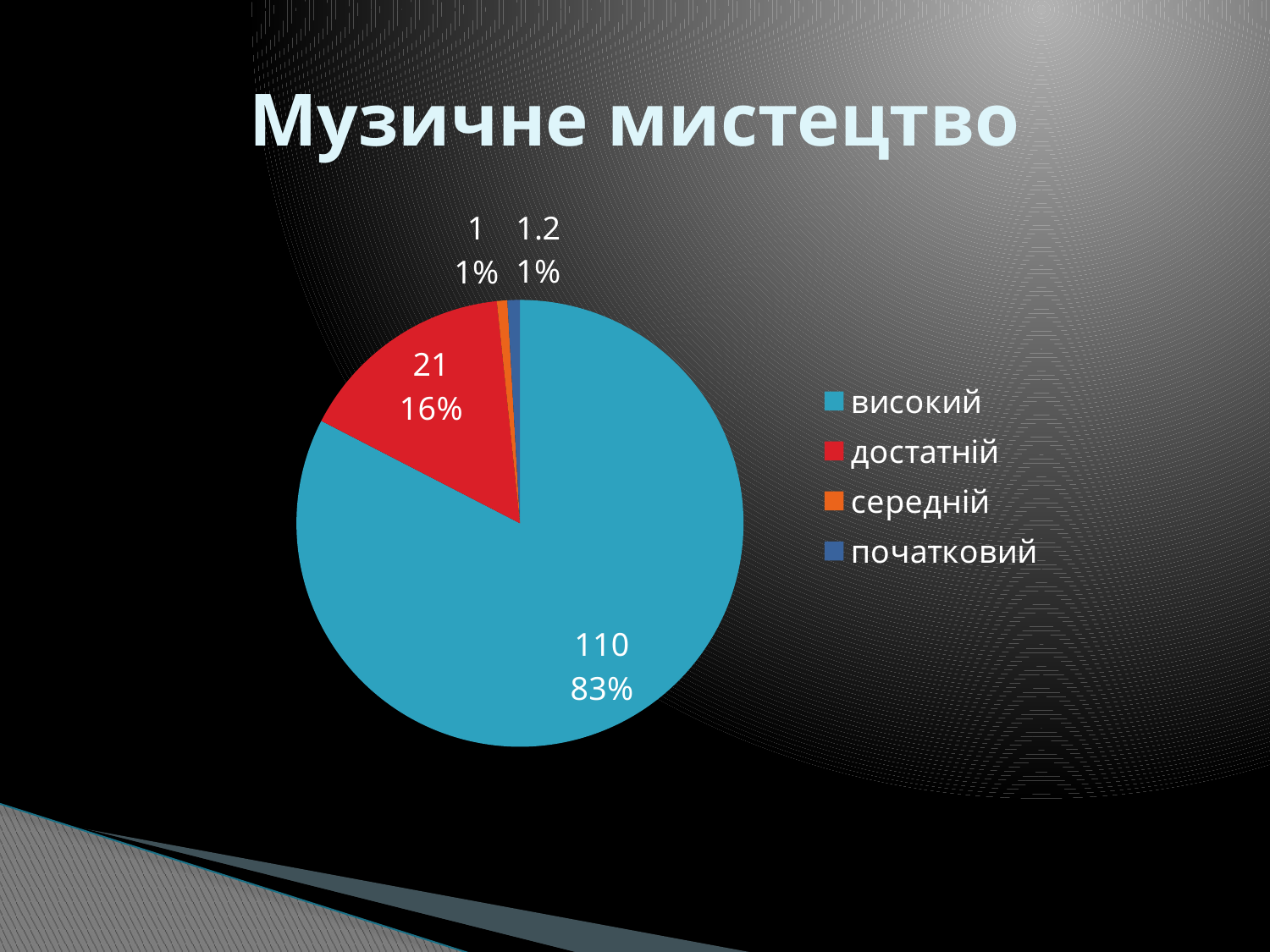
What kind of chart is shown on the slide? pie chart How many slices does the pie chart have? 4 Which is larger, the 'високий' slice or the 'достатній' slice? високий How many entries does the legend list? 4 What is the value shown for the 'високий' slice? 110 Which category has the largest slice of the pie? високий What share of the pie does the 'достатній' slice represent? 16% What colour is the 'достатній' slice? red What share of the pie does the 'високий' slice represent? 83% What is the value shown for the 'достатній' slice? 21 What is the title of the chart? Музичне мистецтво What is the difference between the values for 'високий' and 'достатній'? 89